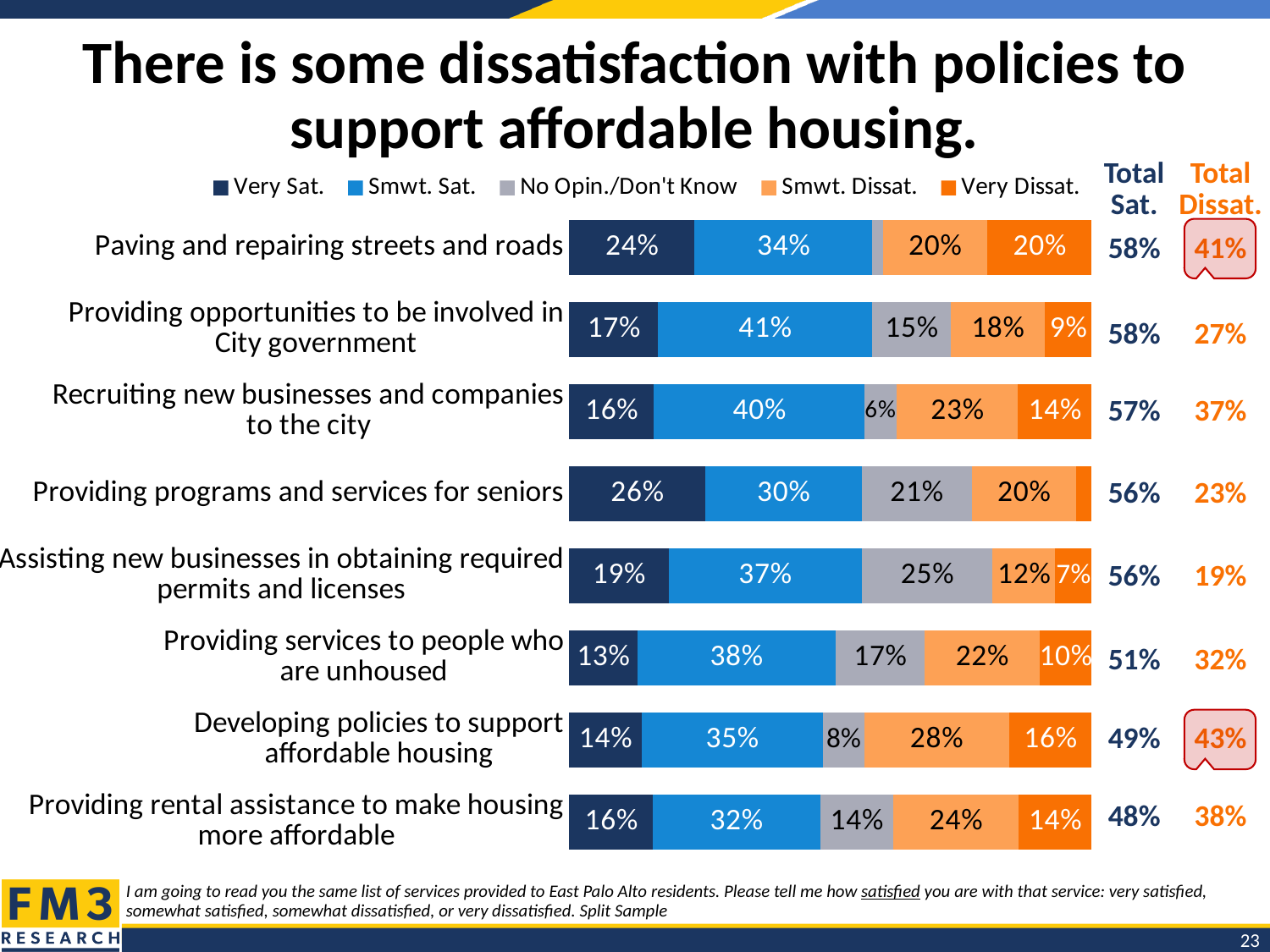
What type of chart is shown on the slide? Stacked bar chart What is the "No Opin./Don't Know" value for recruiting new businesses and companies to the city? 6% What percentage of respondents are "Very Sat." with paving and repairing streets and roads? 24% Which has a larger "Smwt. Sat." value: providing opportunities to be involved in City government or providing programs and services for seniors? Providing opportunities to be involved in City government What is the Total Dissat. figure for developing policies to support affordable housing? 43% Which service has the lowest Total Dissat. value? Assisting new businesses in obtaining required permits and licenses Which service has the lowest Total Sat. value? Providing rental assistance to make housing more affordable How many services are listed in the chart? 8 How many percentage points higher is the "Very Dissat." value for paving and repairing streets and roads than for providing opportunities to be involved in City government? 11 percentage points How many series does the legend list? 5 Which service has the highest Total Dissat. value? Developing policies to support affordable housing What is the "Smwt. Dissat." value for developing policies to support affordable housing? 28%